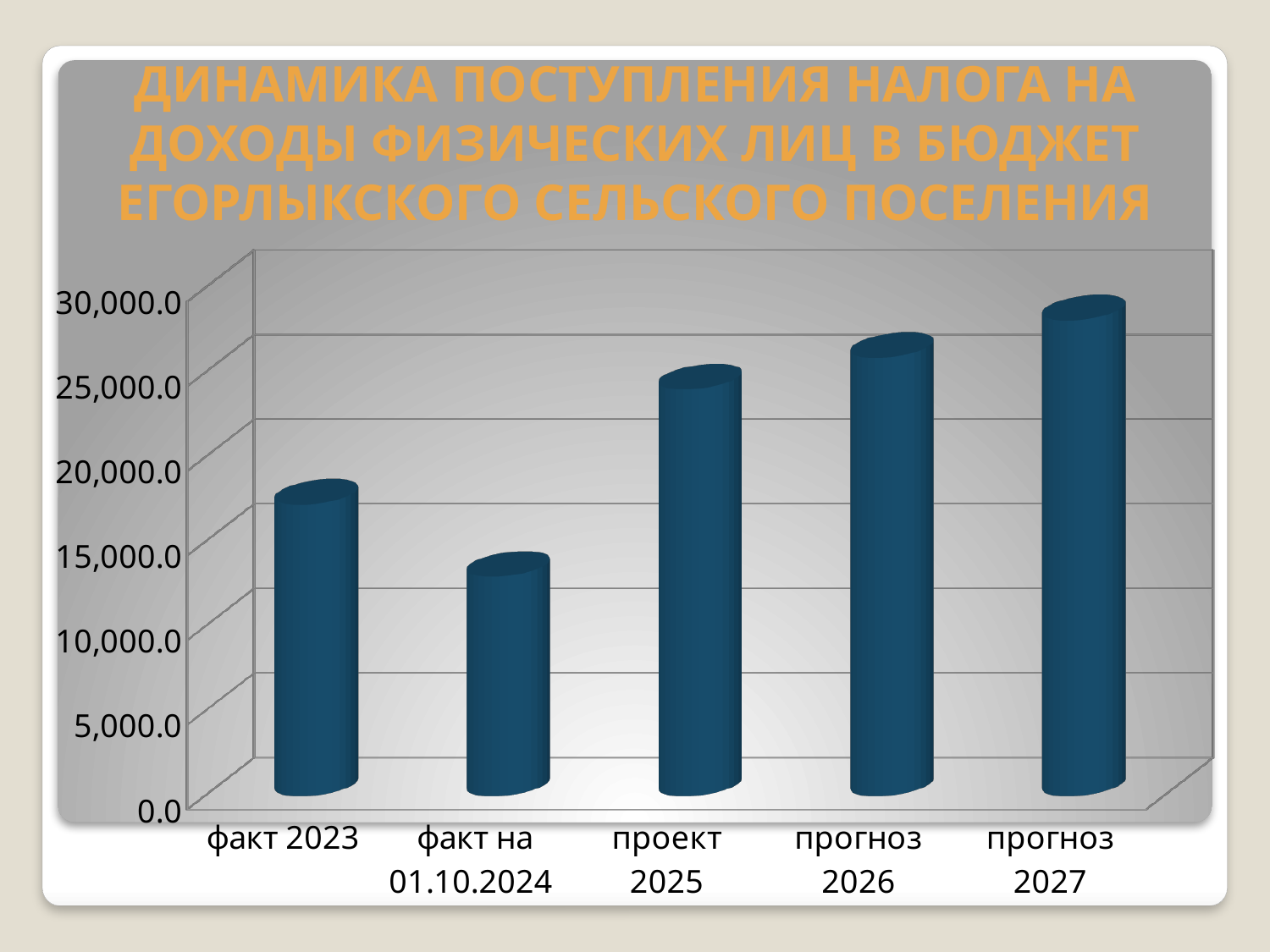
Do the values rise or fall from проект 2025 to прогноз 2027? rise Is the value for факт на 01.10.2024 greater or less than 15,000.0? less How many categories are shown on the x axis of the chart? 5 Is the value for факт 2023 greater or less than 20,000.0? less Is the value for проект 2025 greater or less than 20,000.0? greater What is the title of the chart on the slide? ДИНАМИКА ПОСТУПЛЕНИЯ НАЛОГА НА ДОХОДЫ ФИЗИЧЕСКИХ ЛИЦ В БЮДЖЕТ ЕГОРЛЫКСКОГО СЕЛЬСКОГО ПОСЕЛЕНИЯ Which category has the highest value in the chart? прогноз 2027 Which category has the lowest value in the chart? факт на 01.10.2024 Which is larger, the value for проект 2025 or the value for факт 2023? проект 2025 What kind of chart is shown on the slide? bar chart